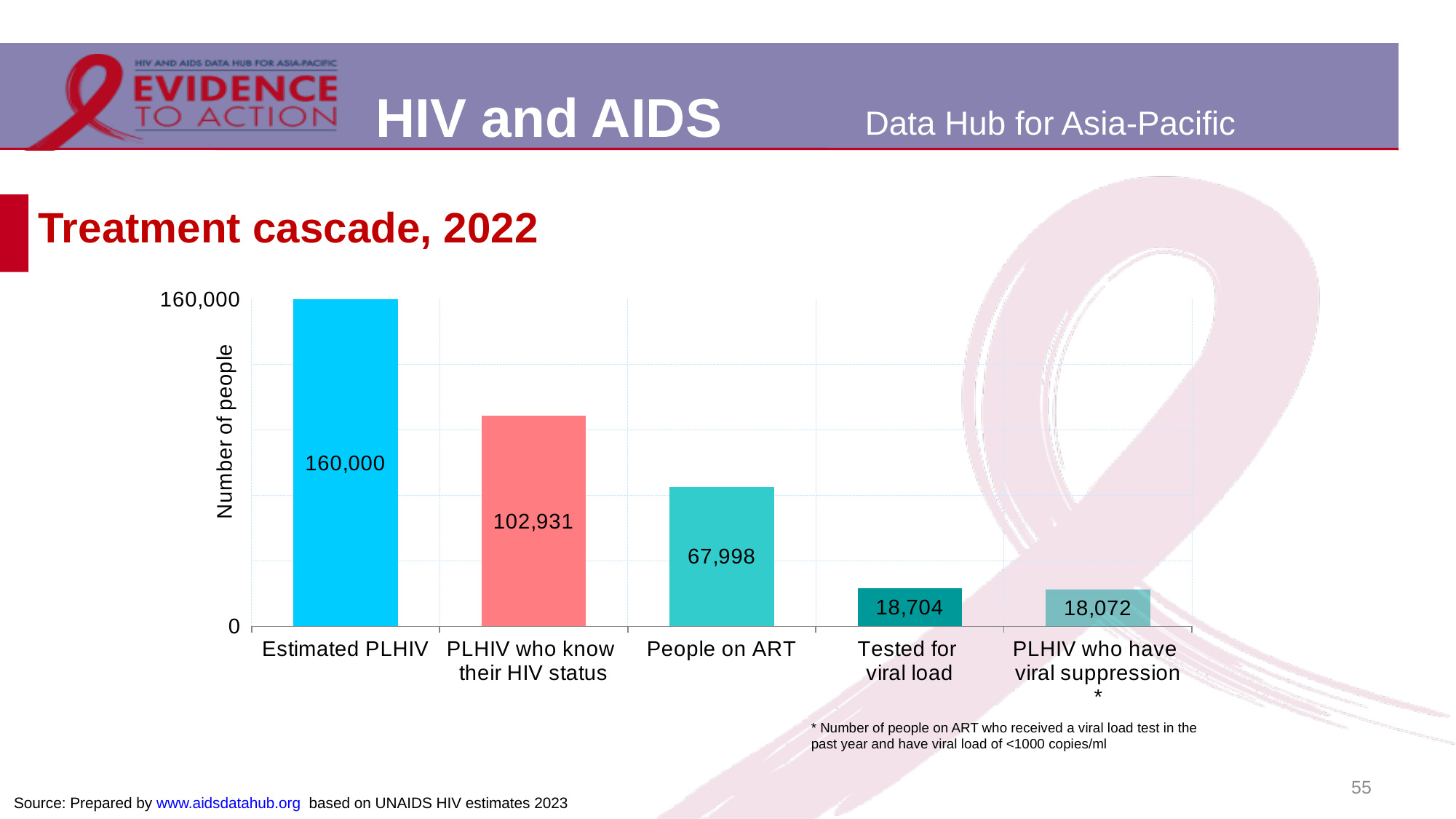
What is the value for Estimated PLHIV? 160,000 Which is larger, PLHIV who know their HIV status or People on ART? PLHIV who know their HIV status What kind of chart is shown on the slide? Bar chart What is the value for PLHIV who know their HIV status? 102,931 What is the value for People on ART? 67,998 What is the difference between Estimated PLHIV and PLHIV who know their HIV status? 57,069 What is the value for PLHIV who have viral suppression? 18,072 Which category has the highest value? Estimated PLHIV How many categories are shown in the chart? 5 What is the difference between People on ART and Tested for viral load? 49,294 Which category has the lowest value? PLHIV who have viral suppression What is the value for Tested for viral load? 18,704